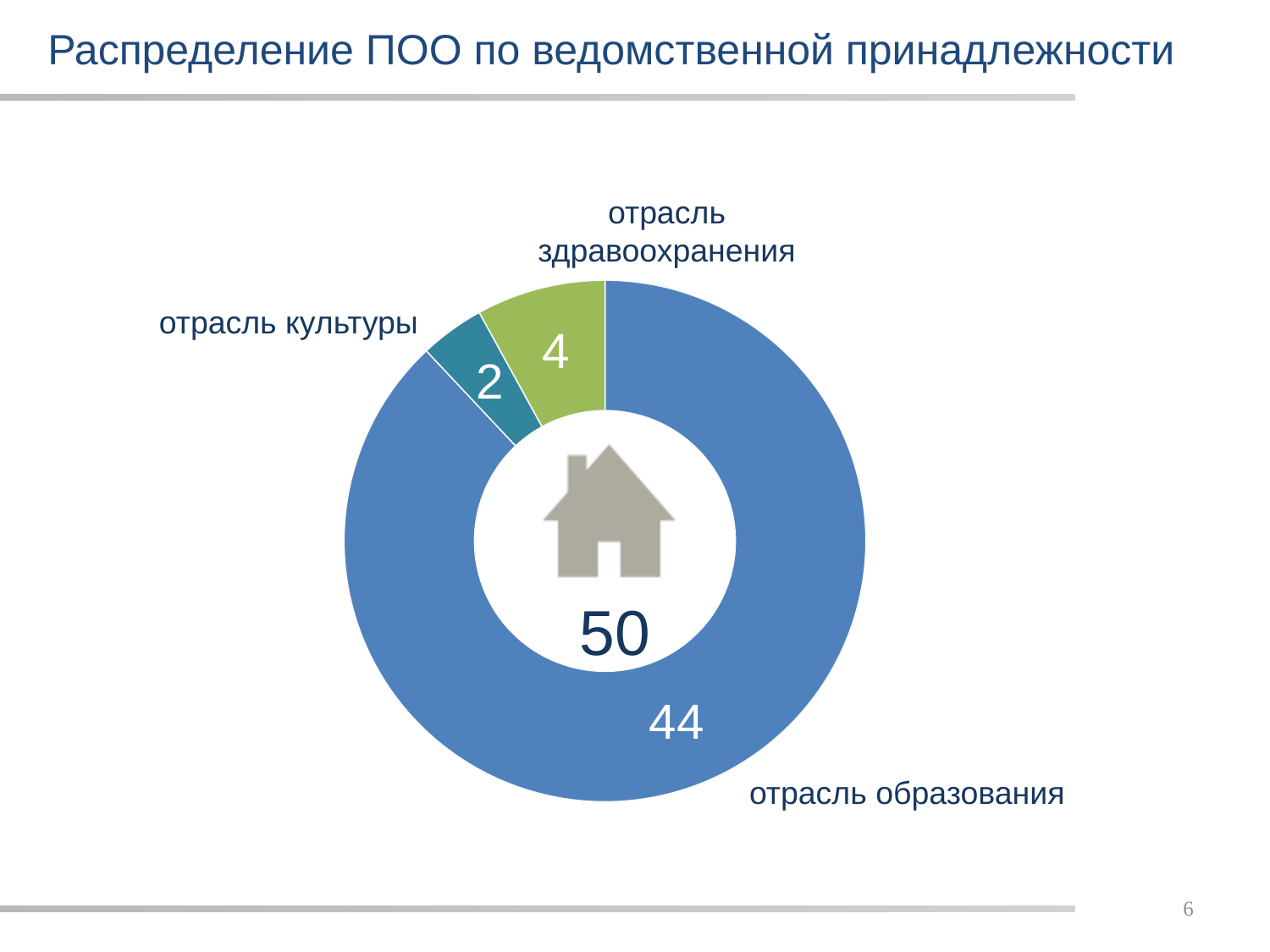
Which category has the smallest slice? отрасль культуры What is the value for отрасль культуры? 2 Which is larger, the value for отрасль здравоохранения or the value for отрасль культуры? отрасль здравоохранения What is the value for отрасль образования? 44 What share of the total does отрасль образования represent? 88% How many categories does the chart show? 3 What kind of chart is shown on the slide? doughnut (pie) chart What is the difference between the values for отрасль образования and отрасль здравоохранения? 40 What number is shown in the centre of the doughnut chart? 50 What is the value for отрасль здравоохранения? 4 What is the difference between the values for отрасль здравоохранения and отрасль культуры? 2 Which category has the largest slice? отрасль образования